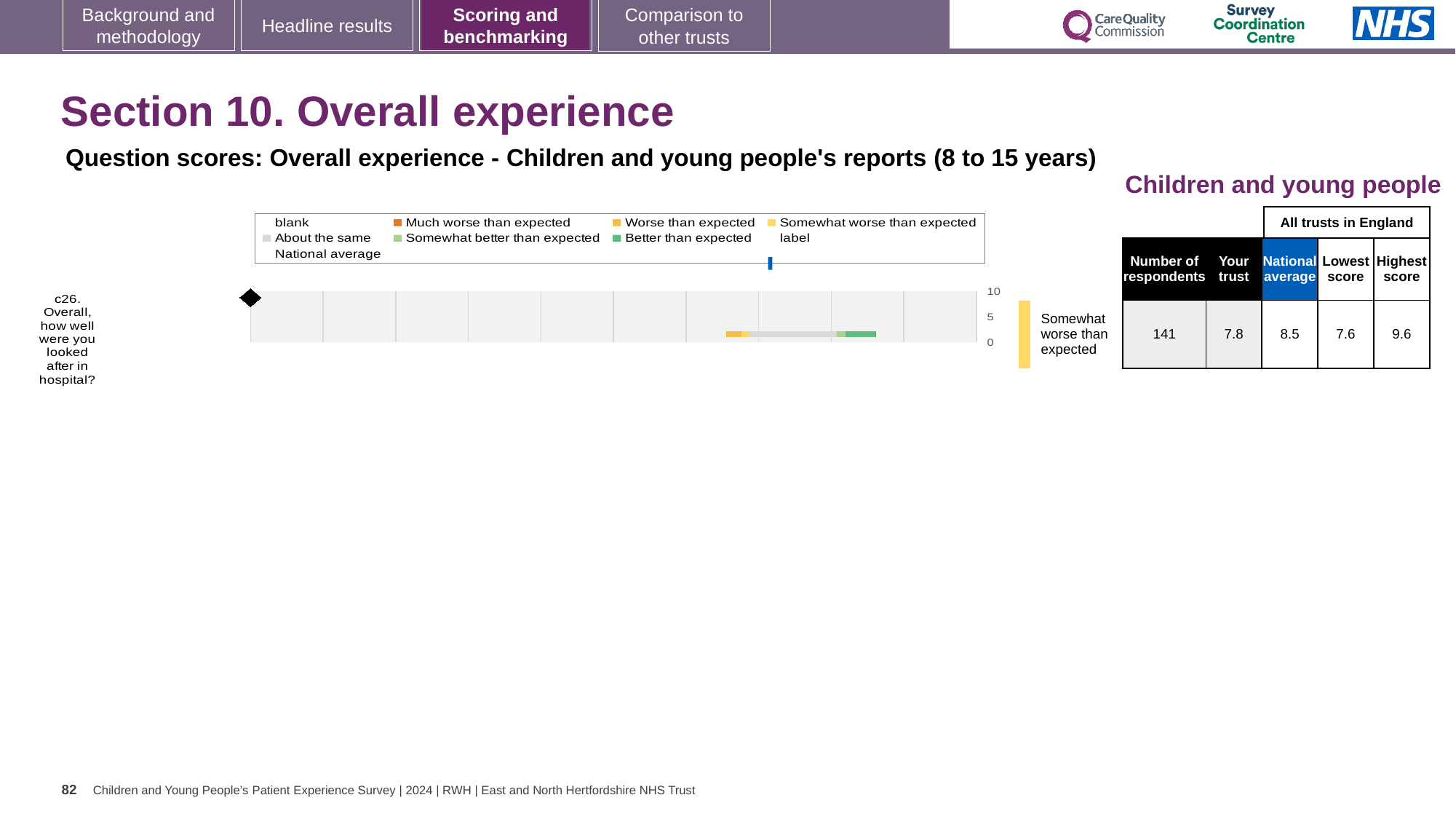
Which question is plotted in the chart? c26. Overall, how well were you looked after in hospital? What benchmark category is shown for question c26? Somewhat worse than expected What is the maximum value shown on the chart's score axis? 10 How many respondents answered question c26? 141 What is the lowest score among all trusts in England for question c26? 7.6 What is the trust's score for question c26? 7.8 How many questions are plotted in the chart? 1 What kind of chart is shown on the slide? bar chart What is the national average score for question c26? 8.5 Which is larger for question c26, the trust's score or the national average? national average What is the highest score among all trusts in England for question c26? 9.6 What is the difference between the national average and the trust's score for question c26? 0.7